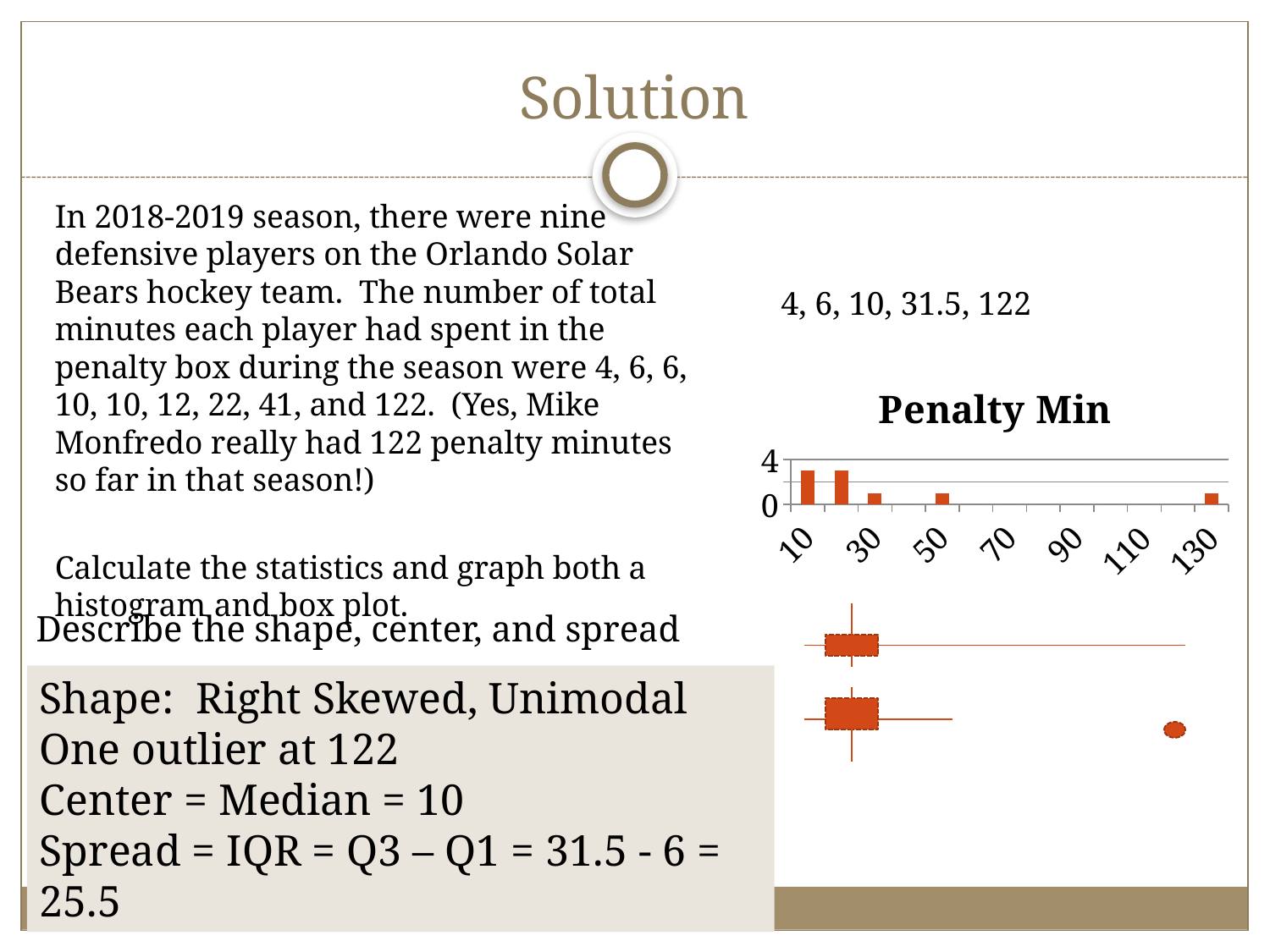
What is the highest x-axis tick label shown on the "Penalty Min" chart? 130 In the "Penalty Min" chart, is the bar at 30 greater or less than 4? less How many bars are plotted in the "Penalty Min" chart? 5 In the "Penalty Min" chart, which bar is taller, the one at 50 or the one at 10? 10 What kind of chart is the "Penalty Min" chart? bar chart In the "Penalty Min" chart, which bar is taller, the one at 10 or the one at 30? 10 How many x-axis tick labels are shown on the "Penalty Min" chart? 7 What is the title of the chart on the slide? Penalty Min In the "Penalty Min" chart, is the bar at 130 greater or less than 4? less Do the bar heights in the "Penalty Min" chart generally rise or fall from left to right along the x axis? fall